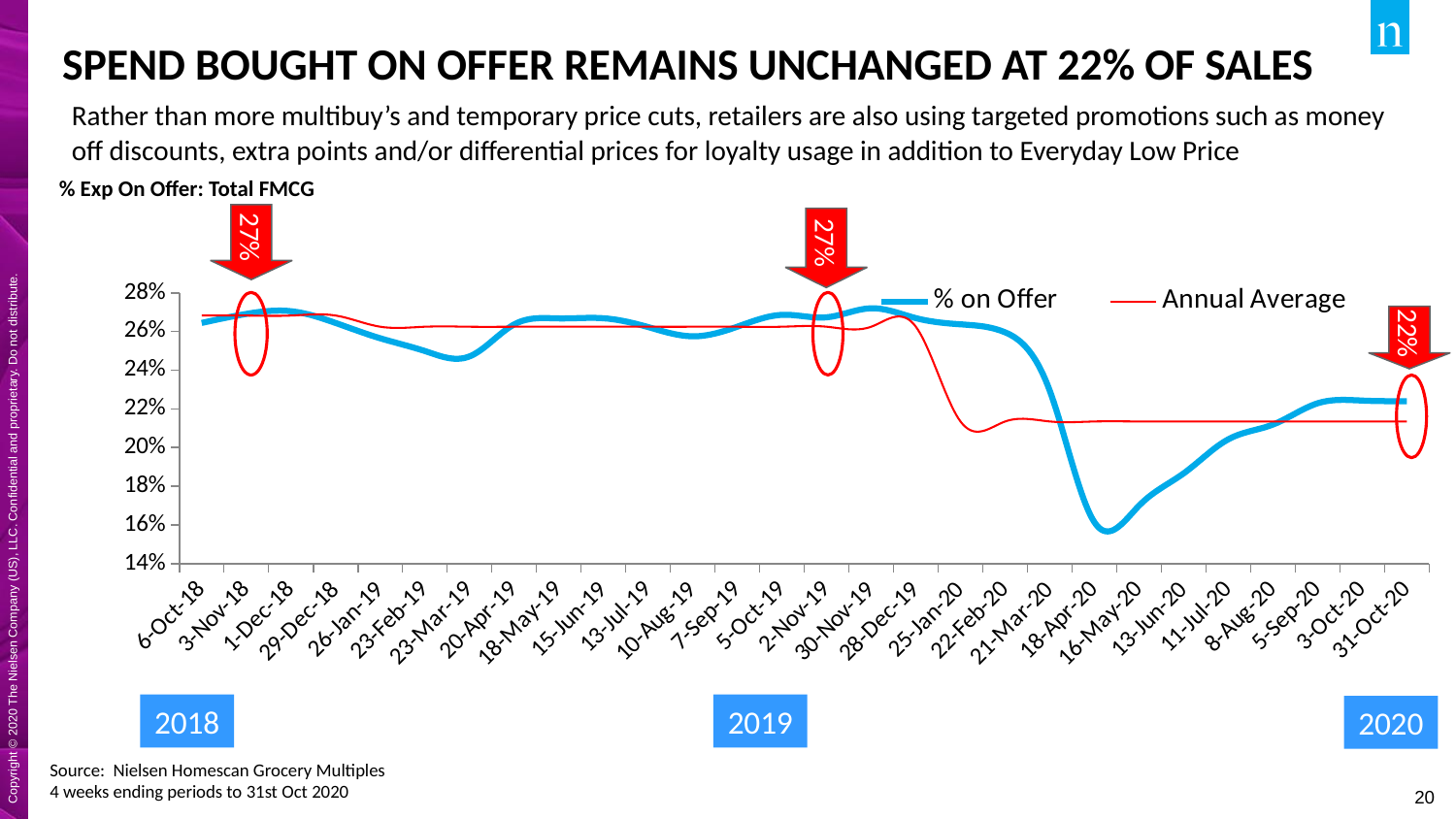
What is the title of the chart? % Exp On Offer: Total FMCG What are the two series named in the legend? % on Offer and Annual Average Which is larger, the % on Offer value at 16-May-20 or at 31-Oct-20? 31-Oct-20 What is the difference between the annotated value around 2-Nov-19 (27%) and the annotated value at 31-Oct-20 (22%)? 5 percentage points Is the % on Offer value at 23-Mar-19 greater or less than 26%? less What value does the annotation show for % on Offer at the end of the series (31-Oct-20)? 22% What value does the annotation show for % on Offer around 2-Nov-19? 27% What value does the annotation show for % on Offer around 3-Nov-18? 27% At which date does the % on Offer line reach its lowest point? 18-Apr-20 How many series does the chart legend list? 2 Is the % on Offer value at 16-May-20 greater or less than 18%? less What type of chart is shown on the slide? Line chart